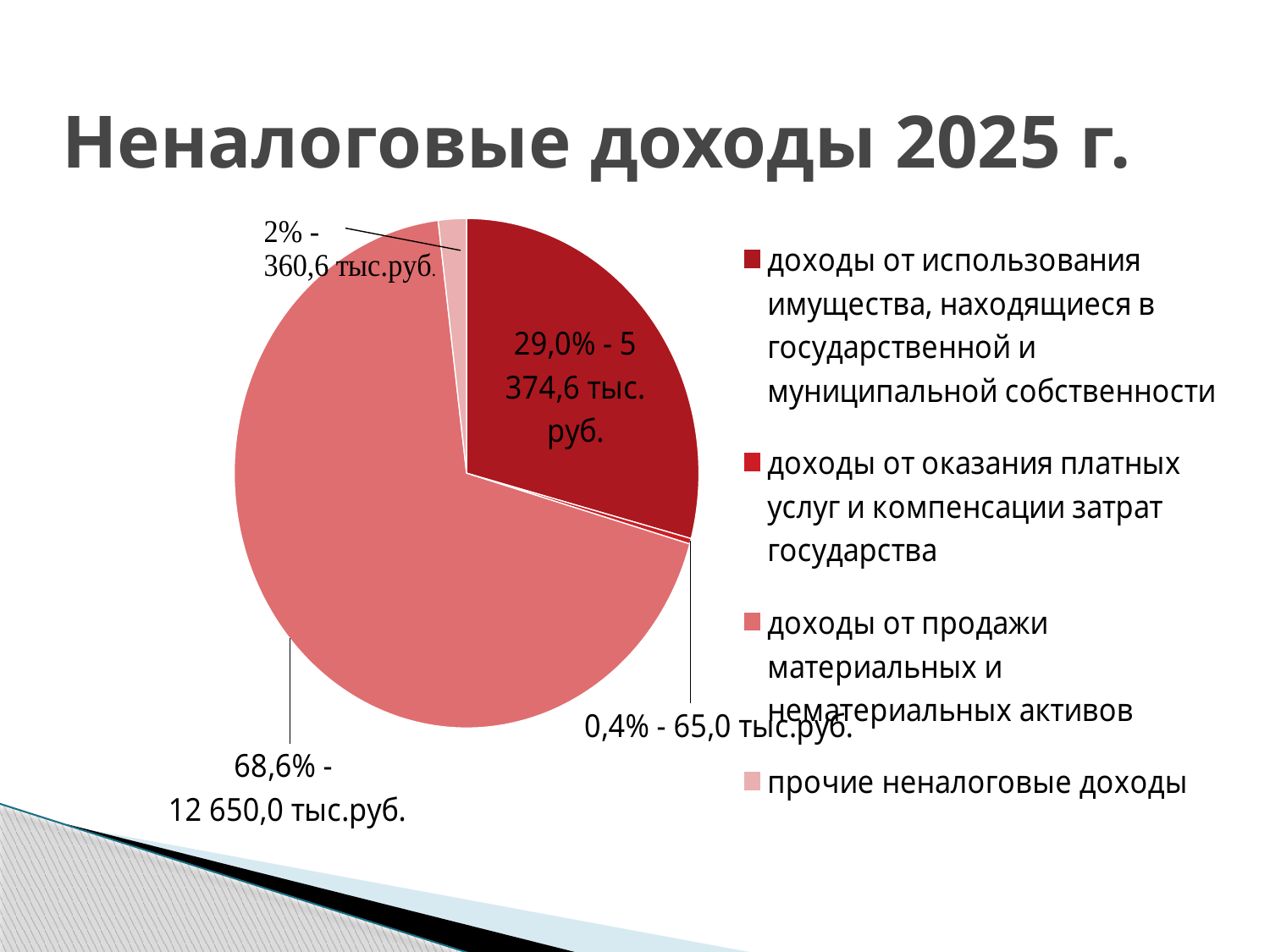
What value in тыс.руб. is shown for 'доходы от использования имущества, находящиеся в государственной и муниципальной собственности'? 5 374,6 тыс.руб. What share of the pie is labelled for 'прочие неналоговые доходы'? 2% What type of chart is shown on the slide? pie chart Which is larger: the slice for 'доходы от использования имущества' or the slice for 'прочие неналоговые доходы'? доходы от использования имущества What value in тыс.руб. is shown for 'доходы от оказания платных услуг и компенсации затрат государства'? 65,0 тыс.руб. What is the difference in percentage points between the 68,6% slice and the 29,0% slice? 39,6 Which category has the largest slice of the pie? доходы от продажи материальных и нематериальных активов How many entries does the legend list? 4 What is the title of the chart on the slide? Неналоговые доходы 2025 г. How many slices does the pie chart have? 4 What share of the pie is labelled for 'доходы от продажи материальных и нематериальных активов'? 68,6% Which category has the smallest slice of the pie? доходы от оказания платных услуг и компенсации затрат государства